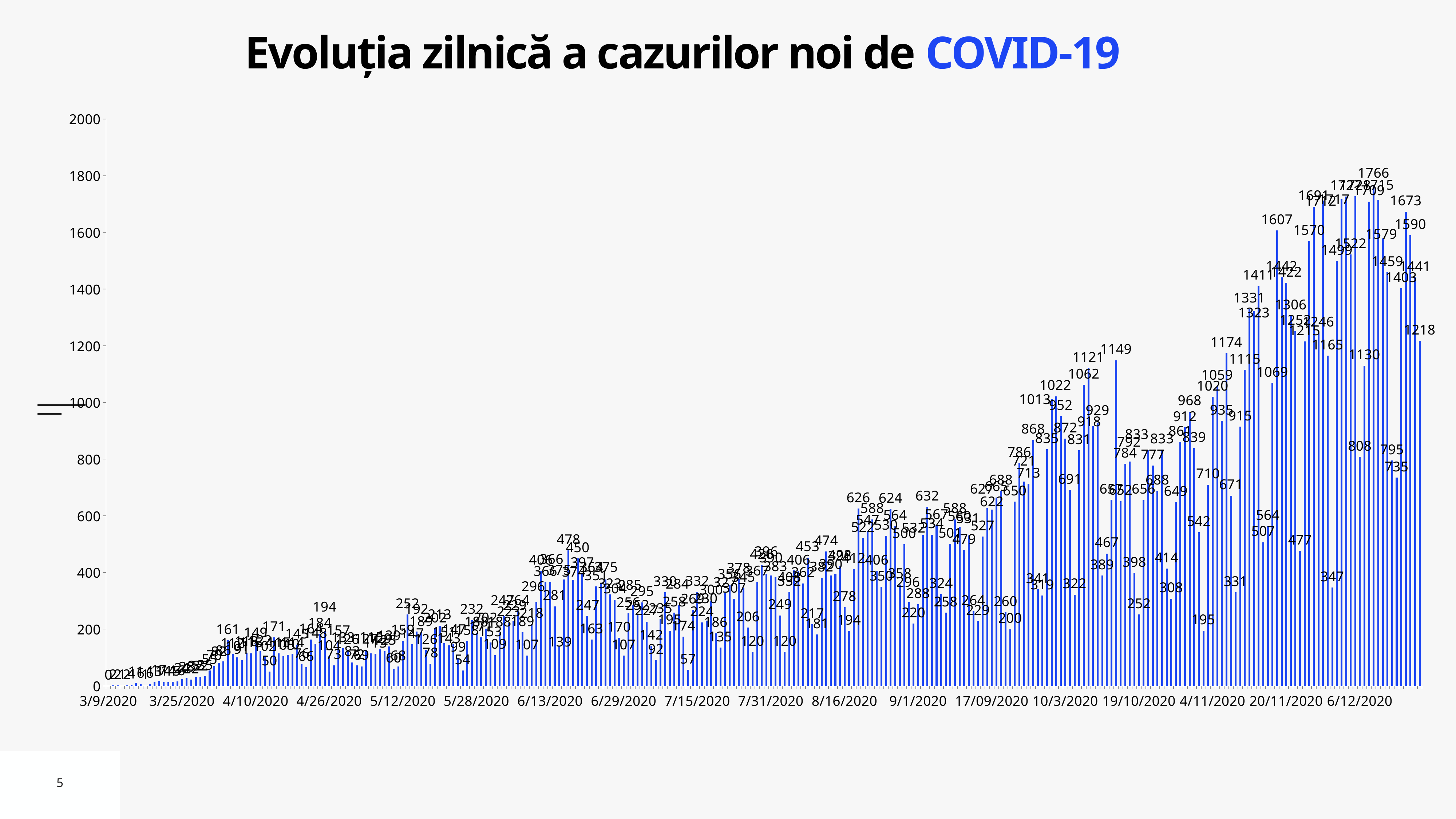
Overall, do the daily values rise or fall from left to right along the x axis? rise Is the value of the last bar on the chart greater or less than 1000? greater What is the maximum value shown on the vertical axis? 2000 What is the difference between the highest labelled value (1766) and the last bar (1218)? 548 What is the highest daily value labelled on the chart? 1766 What is the first date label on the x axis? 3/9/2020 What kind of chart is shown on the slide? bar chart What is the value of the first bar, at 3/9/2020? 0 Is the highest bar on the chart greater or less than 1600? greater What is the title of the chart? Evoluția zilnică a cazurilor noi de COVID-19 Which is larger, the bar labelled 1607 or the bar labelled 1766? 1766 What is the value of the rightmost (last) bar on the chart? 1218